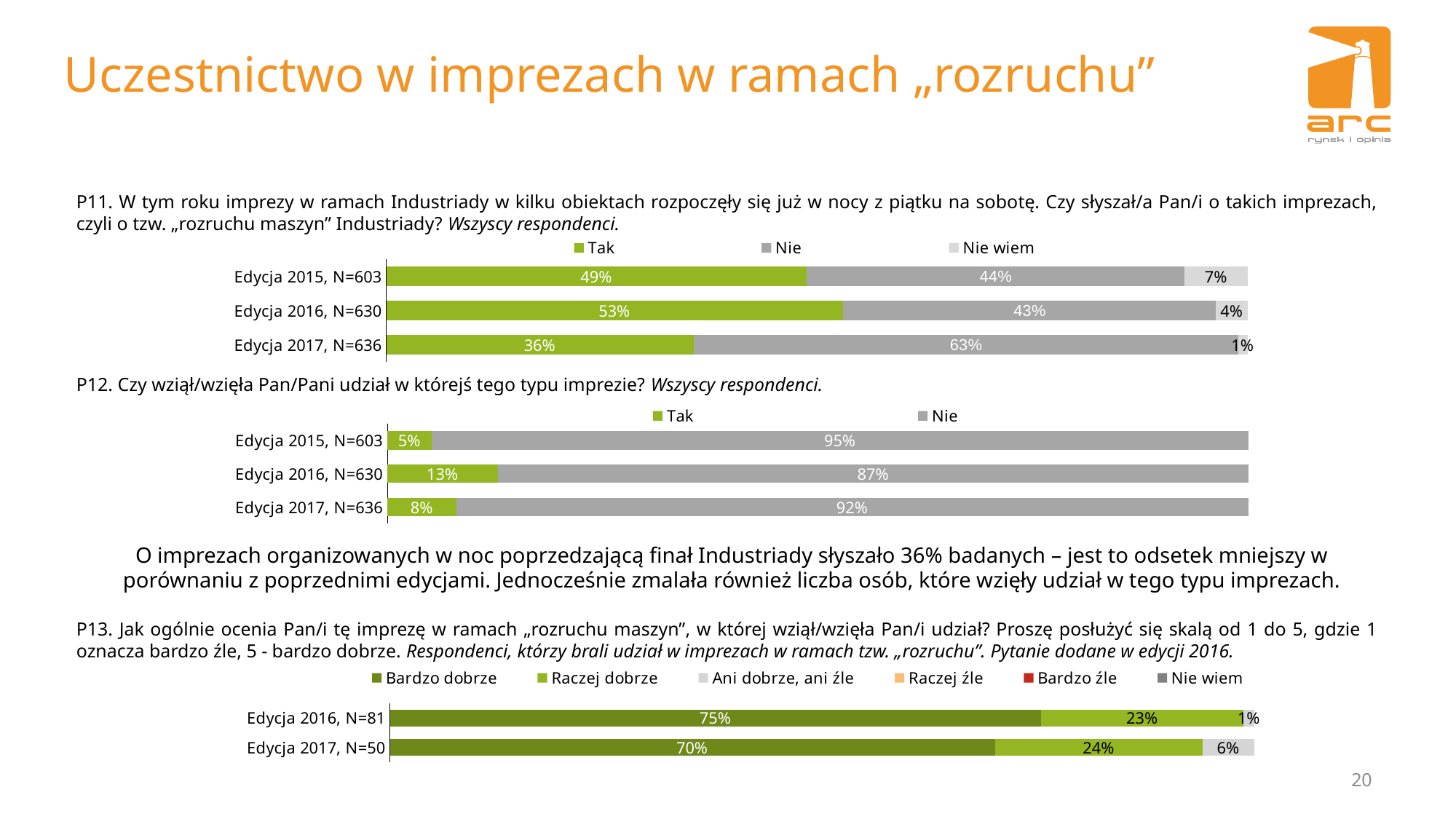
In the P11 chart (top), which edition has the highest Nie value? Edycja 2017, N=636 In the P12 chart (middle), what is the value for Tak in Edycja 2016, N=630? 13% In the P12 chart (middle), what is the value for Nie in Edycja 2017, N=636? 92% In the P11 chart (top), how many series does the legend list? 3 In the P11 chart (top), what is the value for Tak in Edycja 2017, N=636? 36% In the P11 chart (top), what is the value for Nie in Edycja 2015, N=603? 44% What type of chart is the P13 chart (bottom)? Stacked horizontal bar chart In the P11 chart (top), what is the difference between the Tak values for Edycja 2016, N=630 and Edycja 2017, N=636? 17 percentage points In the P12 chart (middle), how many editions (bars) are shown? 3 In the P13 chart (bottom), how many series does the legend list? 6 In the P13 chart (bottom), what is the value for Bardzo dobrze in Edycja 2017, N=50? 70% In the P12 chart (middle), which edition has the lowest Tak value? Edycja 2015, N=603